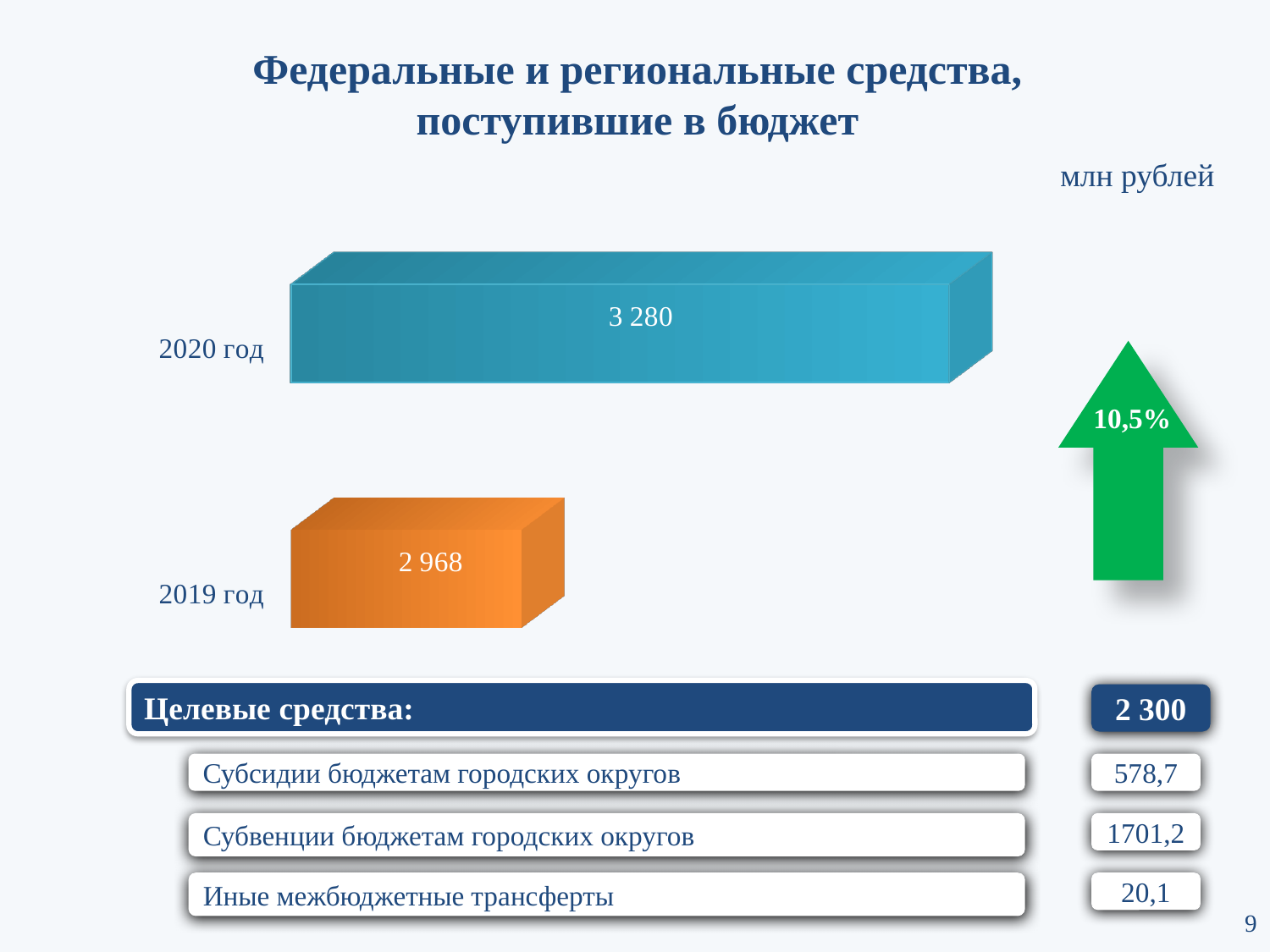
What is the difference between the values for 2020 год and 2019 год? 312 What percentage change is shown on the green arrow next to the chart? 10,5% Which category has the highest value in the chart? 2020 год What is the value for 2019 год? 2 968 How many bars are shown in the chart? 2 What type of chart is shown on the slide? bar chart What unit of measurement is indicated for the chart values? млн рублей Which year has the higher value, 2019 год or 2020 год? 2020 год What is the value for 2020 год? 3 280 Did the value rise or fall from 2019 год to 2020 год? rise Which category has the lowest value in the chart? 2019 год